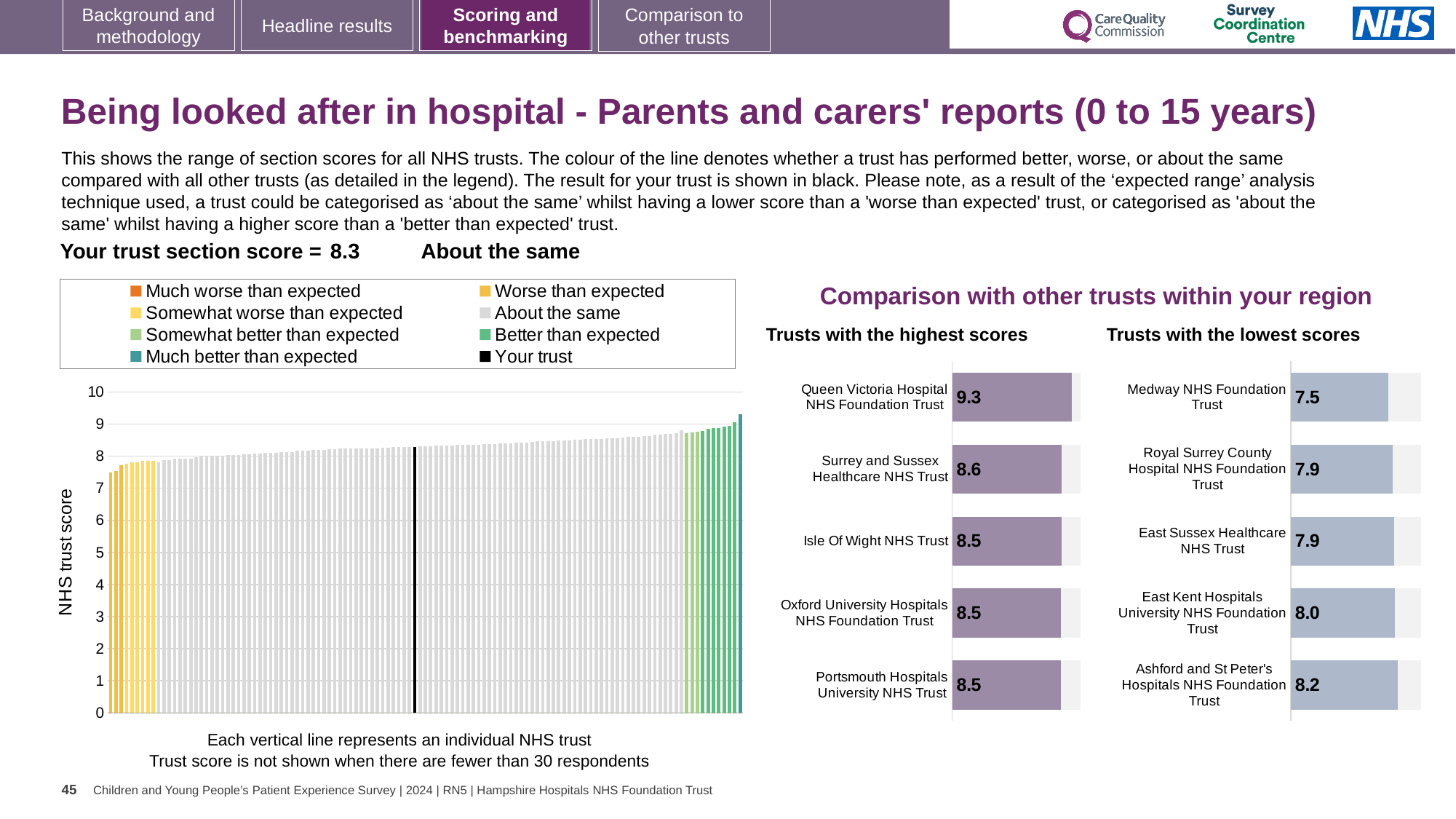
In the 'Trusts with the lowest scores' chart, which trust has the lowest score? Medway NHS Foundation Trust In the 'Trusts with the lowest scores' chart, what is the score for Ashford and St Peter's Hospitals NHS Foundation Trust? 8.2 Which is larger: the score for East Kent Hospitals University NHS Foundation Trust in the lowest scores chart or the score for Isle Of Wight NHS Trust in the highest scores chart? Isle Of Wight NHS Trust In the 'Trusts with the lowest scores' chart, what is the score for Medway NHS Foundation Trust? 7.5 In the 'Trusts with the highest scores' chart, what is the difference between the scores of Queen Victoria Hospital NHS Foundation Trust and Surrey and Sussex Healthcare NHS Trust? 0.7 In the 'Trusts with the highest scores' chart, which trust has the highest score? Queen Victoria Hospital NHS Foundation Trust In the 'Trusts with the highest scores' chart, what is the score for Queen Victoria Hospital NHS Foundation Trust? 9.3 How many trusts are shown in the 'Trusts with the lowest scores' chart? 5 In the 'Trusts with the highest scores' chart, what is the score for Surrey and Sussex Healthcare NHS Trust? 8.6 In the large chart on the left, do the trust scores rise or fall from left to right? rise How many entries does the legend above the large chart on the left list? 8 In the large chart on the left, is the value for your trust (the black line) greater or less than 8? greater